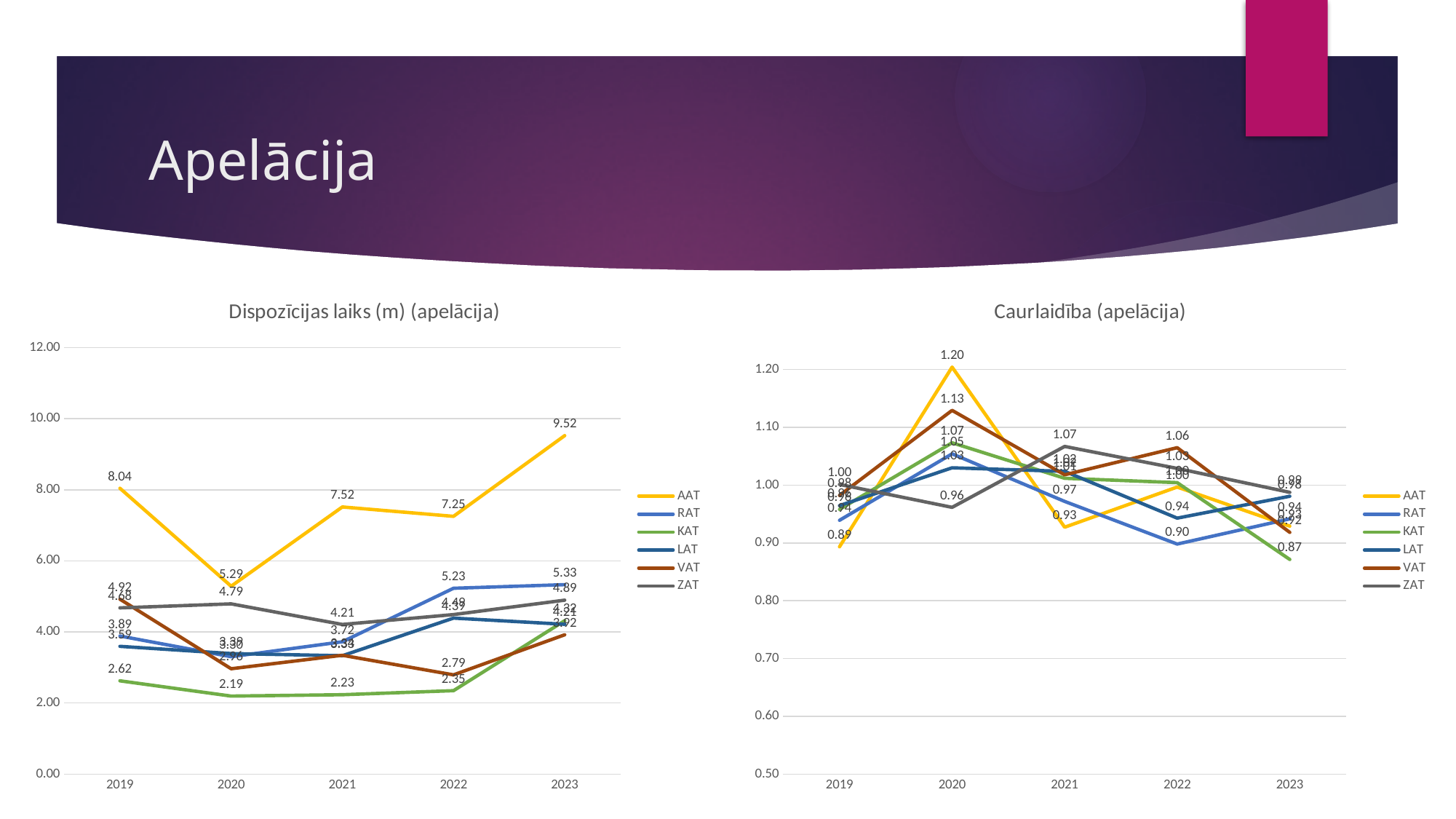
In the "Dispozīcijas laiks (m) (apelācija)" chart, what is the KAT value for 2020? 2.19 In the "Caurlaidība (apelācija)" chart, which series has the lowest value in 2023? KAT In the "Dispozīcijas laiks (m) (apelācija)" chart, what is the difference between the AAT values for 2023 and 2019? 1.48 In the "Dispozīcijas laiks (m) (apelācija)" chart, which is larger in 2019, AAT or ZAT? AAT In the "Dispozīcijas laiks (m) (apelācija)" chart, in which year is the AAT value lowest? 2020 In the "Caurlaidība (apelācija)" chart, which series has the highest value in 2020? AAT In the "Caurlaidība (apelācija)" chart, what is the AAT value for 2020? 1.20 In the "Caurlaidība (apelācija)" chart, what is the RAT value for 2022? 0.90 What kind of chart is "Dispozīcijas laiks (m) (apelācija)"? line chart In the "Dispozīcijas laiks (m) (apelācija)" chart, what is the AAT value for 2023? 9.52 How many years are shown on the x axis of the "Dispozīcijas laiks (m) (apelācija)" chart? 5 How many series does the legend of the "Caurlaidība (apelācija)" chart list? 6